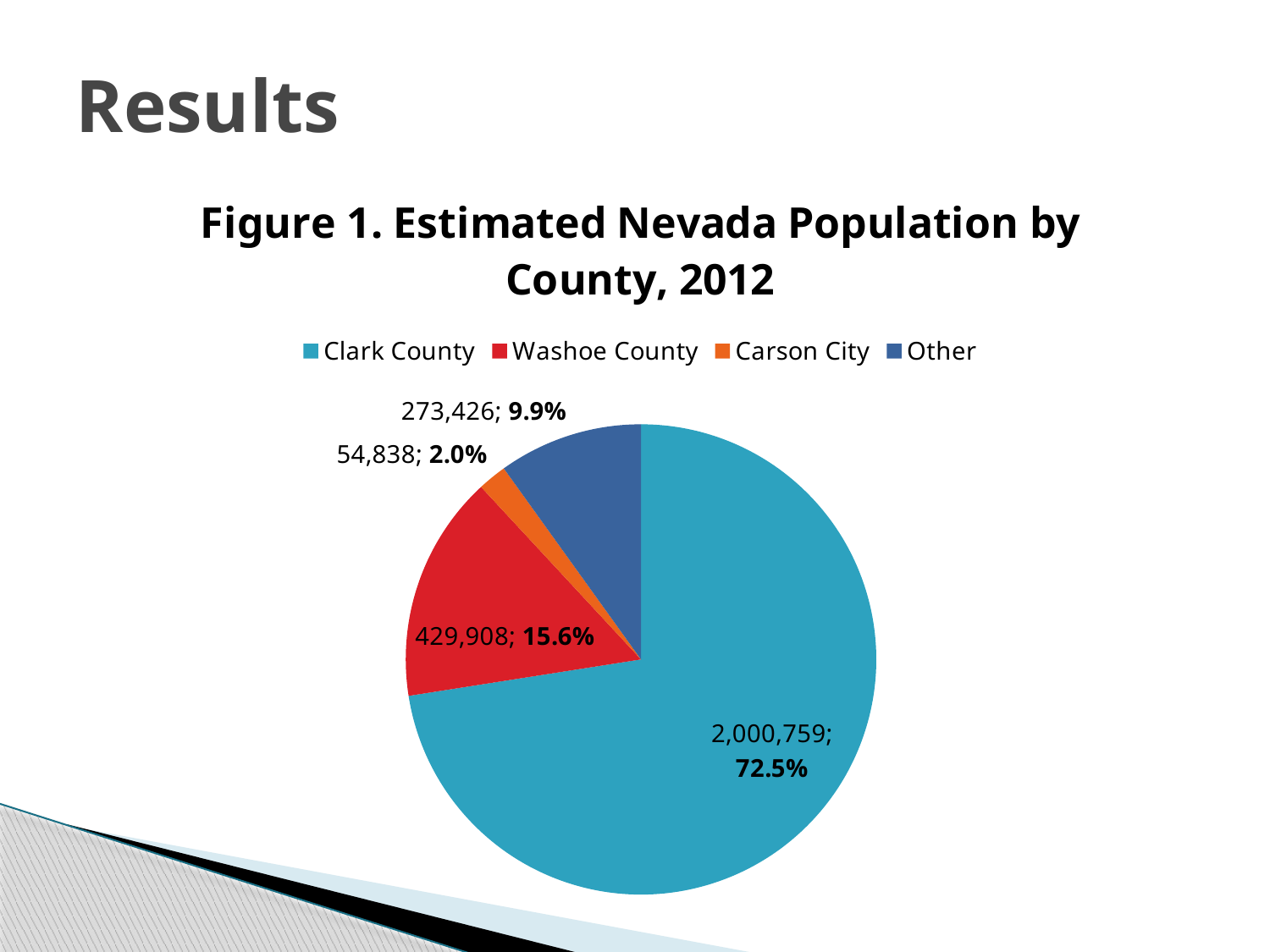
What share of the pie does Clark County represent? 72.5% What is the estimated population of Washoe County? 429,908 How many categories does the legend list? 4 What is the estimated population of Carson City? 54,838 Which is larger, the Other category or Washoe County? Washoe County Which category has the smallest slice of the pie? Carson City Which category has the largest slice of the pie? Clark County What share of the pie does Washoe County represent? 15.6% What is the estimated population of Clark County? 2,000,759 What is the difference in population between Washoe County and Carson City? 375,070 What is the estimated population for the Other category? 273,426 What type of chart is shown on the slide? Pie chart